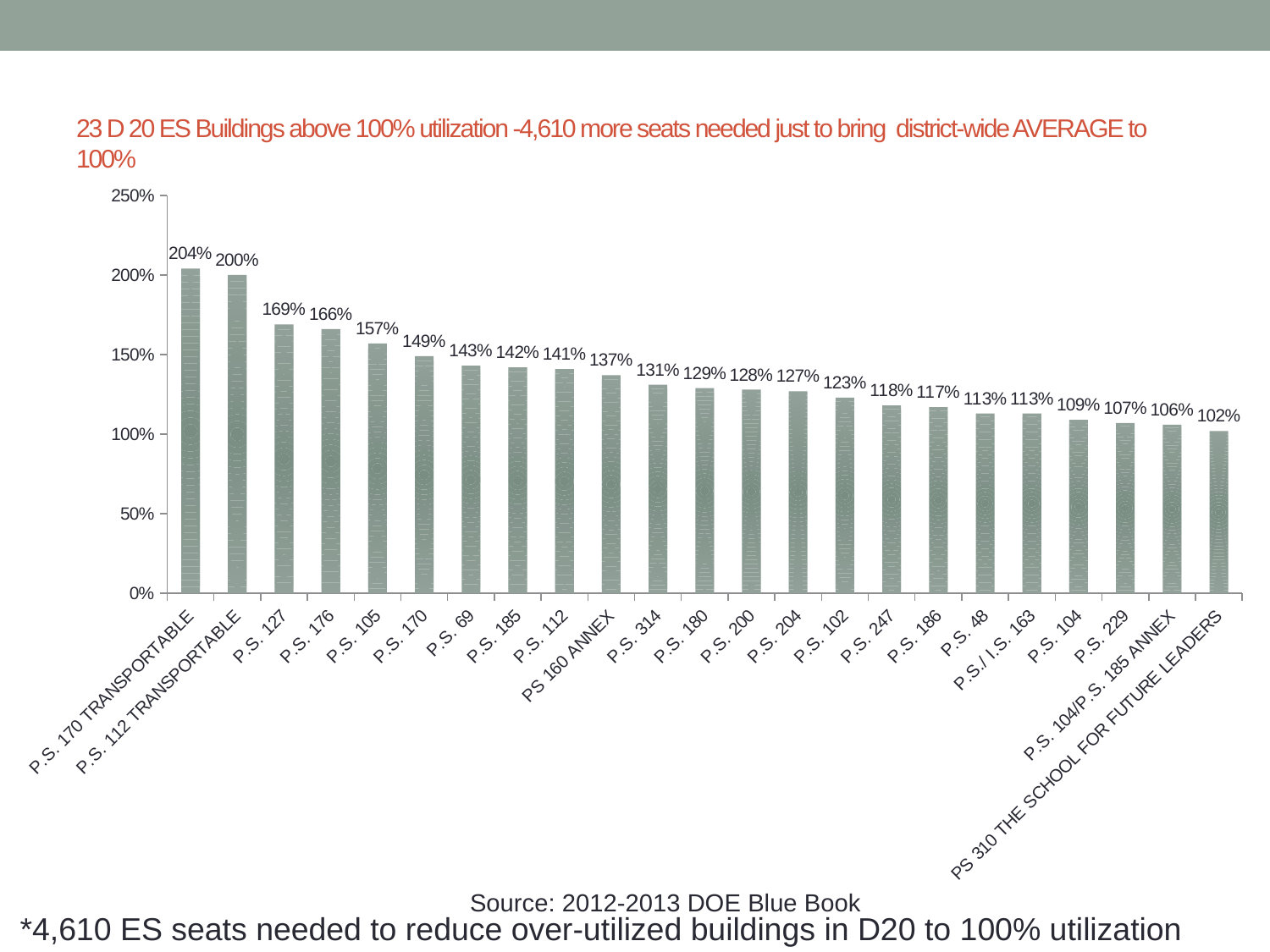
Which building has the highest utilization? P.S. 170 TRANSPORTABLE How many buildings are shown in the chart? 23 What is the utilization value for P.S. 247? 118% Which building has the lowest utilization? PS 310 THE SCHOOL FOR FUTURE LEADERS What kind of chart is shown on the slide? bar chart Is the utilization for P.S. 69 greater or less than 150%? less What is the difference in utilization between P.S. 105 and P.S. 102? 34% Do the utilization values rise or fall from left to right along the x axis? fall What is the utilization value for P.S. 127? 169% What is the difference in utilization between P.S. 170 TRANSPORTABLE and P.S. 112 TRANSPORTABLE? 4% Which has a higher utilization, P.S. 176 or P.S. 180? P.S. 176 What is the utilization value for P.S. 314? 131%